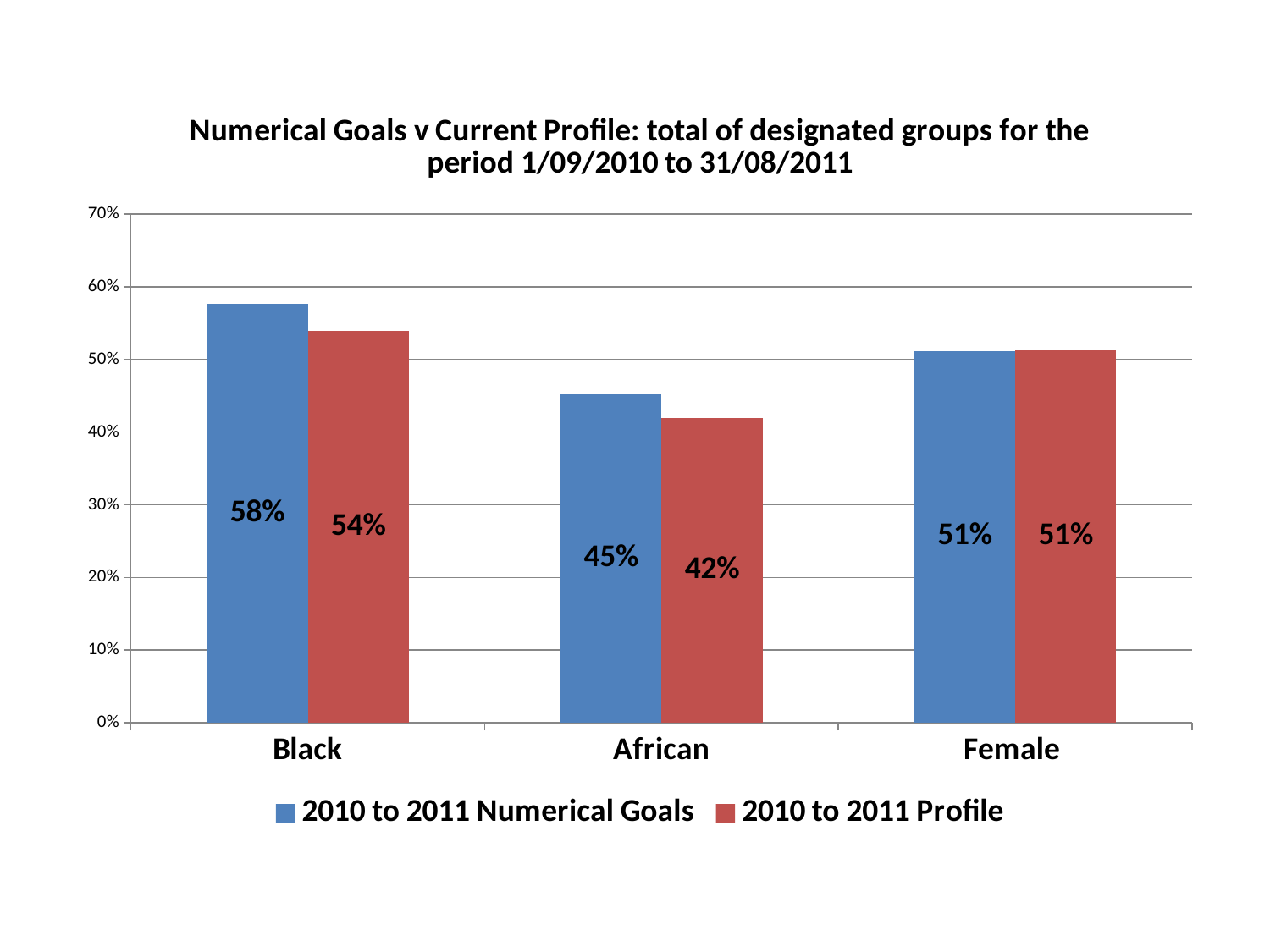
What kind of chart is shown on the slide? bar chart How many series does the legend list? 2 What is the 2010 to 2011 Numerical Goals value for Black? 58% What is the 2010 to 2011 Profile value for Female? 51% What is the 2010 to 2011 Profile value for African? 42% Is the 2010 to 2011 Profile value for Black greater or less than 50%? greater What is the difference between the Numerical Goals and Profile values for Black? 4% Which category has the highest 2010 to 2011 Numerical Goals value? Black How many categories are shown on the x axis? 3 Which category has the lowest 2010 to 2011 Profile value? African Which is larger for African: the 2010 to 2011 Numerical Goals value or the 2010 to 2011 Profile value? 2010 to 2011 Numerical Goals What is the difference between the Numerical Goals values for Black and African? 13%